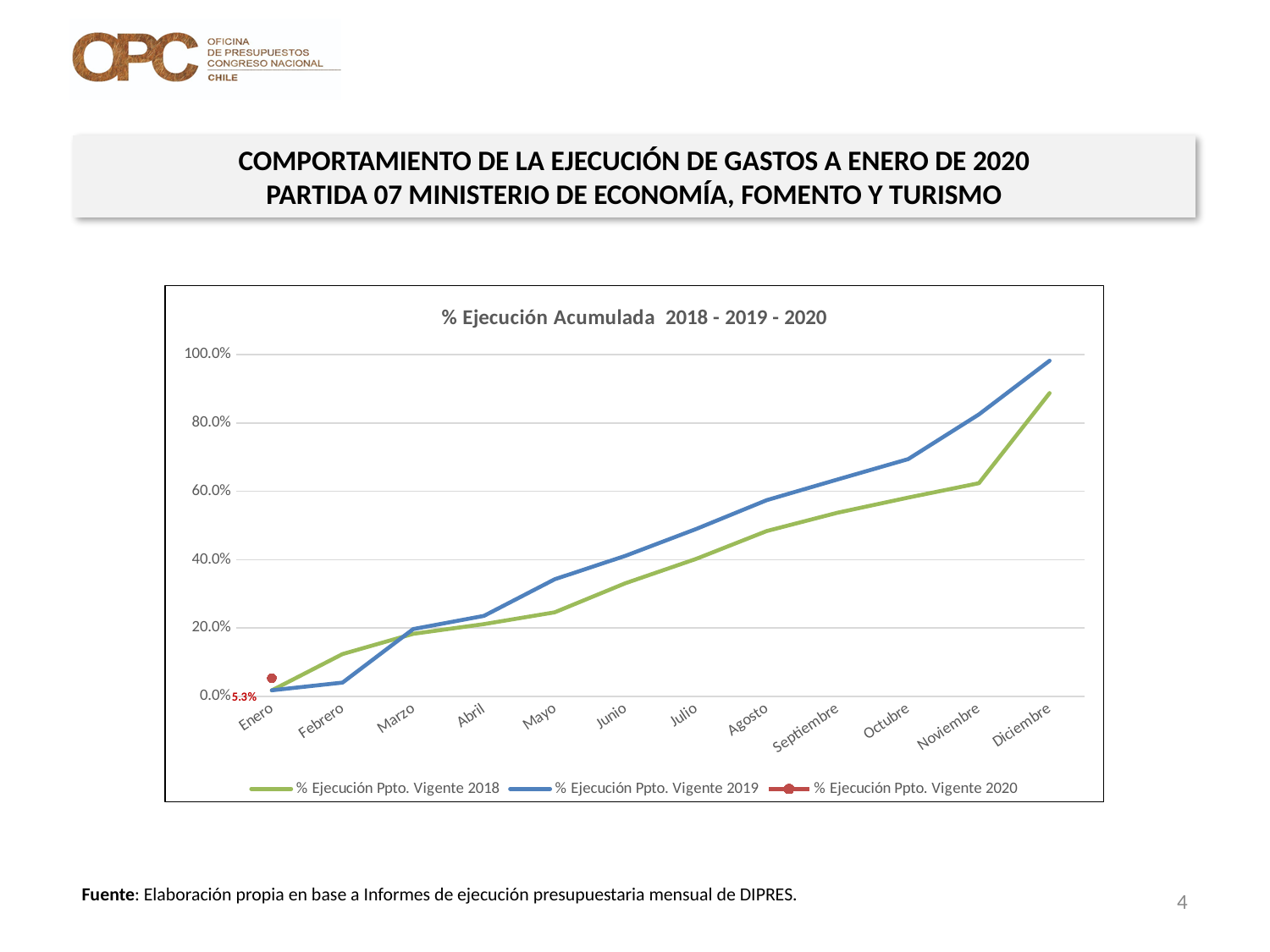
What kind of chart is shown on the slide? Line chart Is the value for % Ejecución Ppto. Vigente 2019 in Diciembre greater or less than 80.0%? greater Is the value for % Ejecución Ppto. Vigente 2019 in Febrero greater or less than 20.0%? less How many series does the chart legend list? 3 How many months are shown along the x axis of the chart? 12 What is the value of % Ejecución Ppto. Vigente 2020 for Enero? 5.3% In Diciembre, which series is higher: % Ejecución Ppto. Vigente 2018 or % Ejecución Ppto. Vigente 2019? % Ejecución Ppto. Vigente 2019 Does the % Ejecución Ppto. Vigente 2019 line rise or fall from Enero to Diciembre? Rise In Febrero, which series is higher: % Ejecución Ppto. Vigente 2018 or % Ejecución Ppto. Vigente 2019? % Ejecución Ppto. Vigente 2018 Is the value for % Ejecución Ppto. Vigente 2018 in Agosto greater or less than 40.0%? greater In which month does % Ejecución Ppto. Vigente 2018 reach its highest value? Diciembre What is the title of the chart? % Ejecución Acumulada 2018 - 2019 - 2020